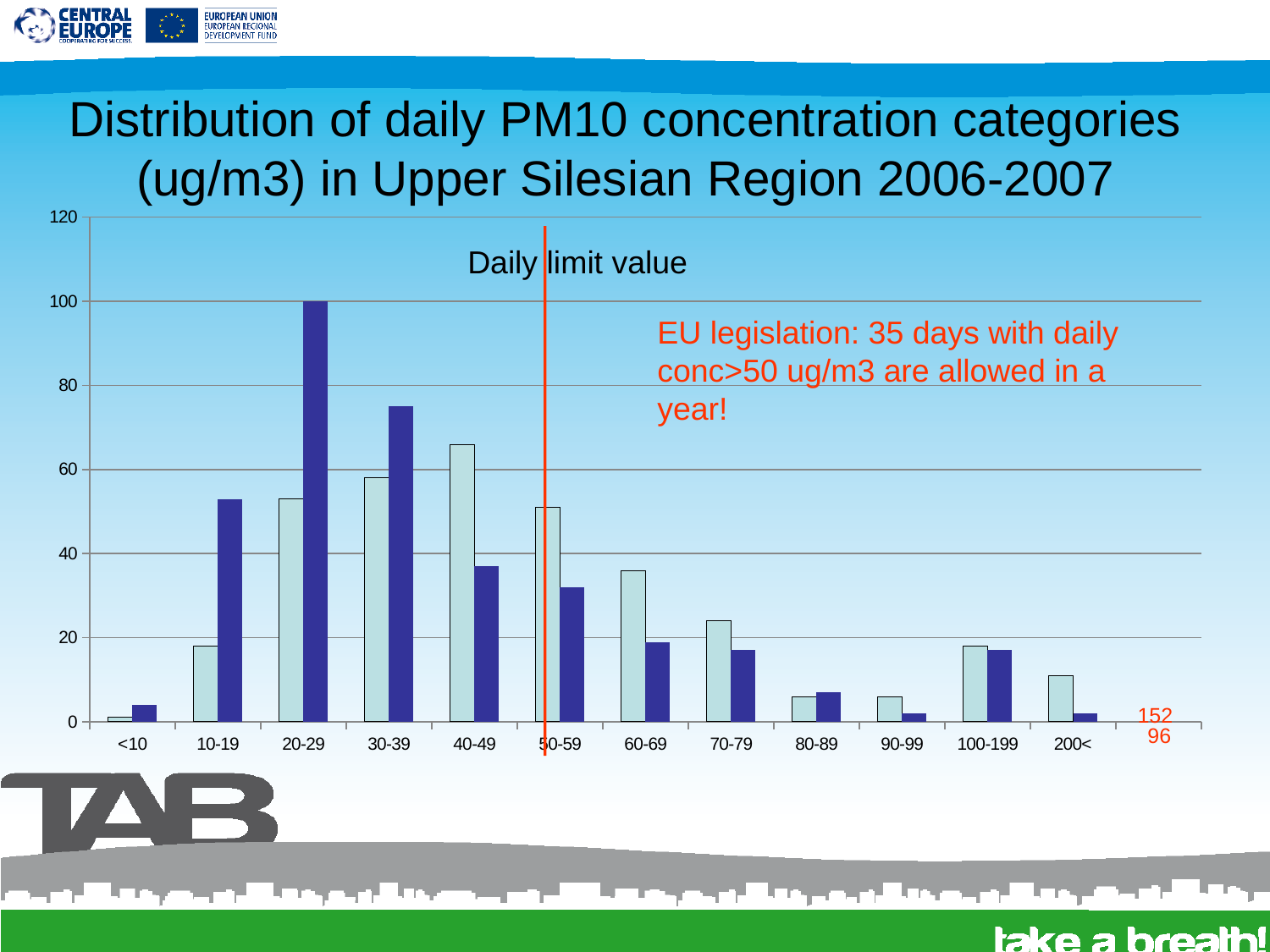
Is the value of the dark blue bar for 50-59 greater or less than 40? less Is the value of the light blue bar for 40-49 greater or less than 60? greater Which category has the lowest light blue bar? <10 What does the red vertical line on the chart represent? Daily limit value How many concentration categories are shown on the x axis? 12 In the 40-49 category, which bar is taller, the light blue or the dark blue one? light blue What kind of chart is shown on the slide? bar chart Which category has the highest light blue bar? 40-49 Is the value of the light blue bar for 70-79 greater or less than 20? greater Which category has the highest dark blue bar? 20-29 What is the value of the dark blue bar for the 20-29 category? 100 In the 10-19 category, which bar is taller, the light blue or the dark blue one? dark blue